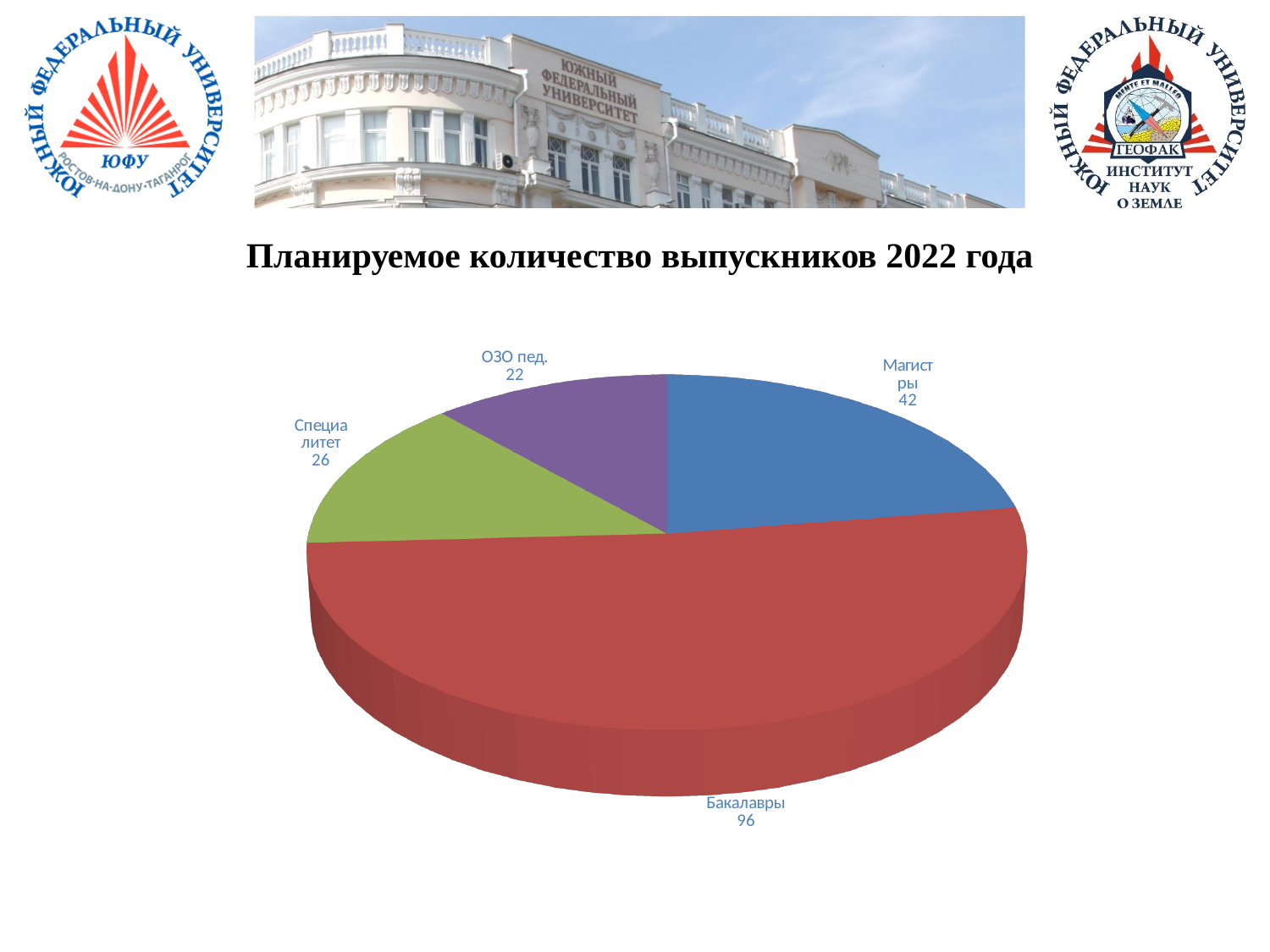
What is the difference between the values for Бакалавры and Магистры? 54 Which is larger, the value for Специалитет or the value for ОЗО пед.? Специалитет What is the planned number of graduates for Бакалавры? 96 What is the value shown for ОЗО пед.? 22 Which category has the largest slice of the pie? Бакалавры Which category has the smallest slice of the pie? ОЗО пед. How many categories (slices) does the pie chart have? 4 What is the title of the chart? Планируемое количество выпускников 2022 года What kind of chart is shown on the slide? Pie chart What is the value shown for Магистры? 42 What is the total of all the values shown in the pie chart? 186 What is the value shown for Специалитет? 26